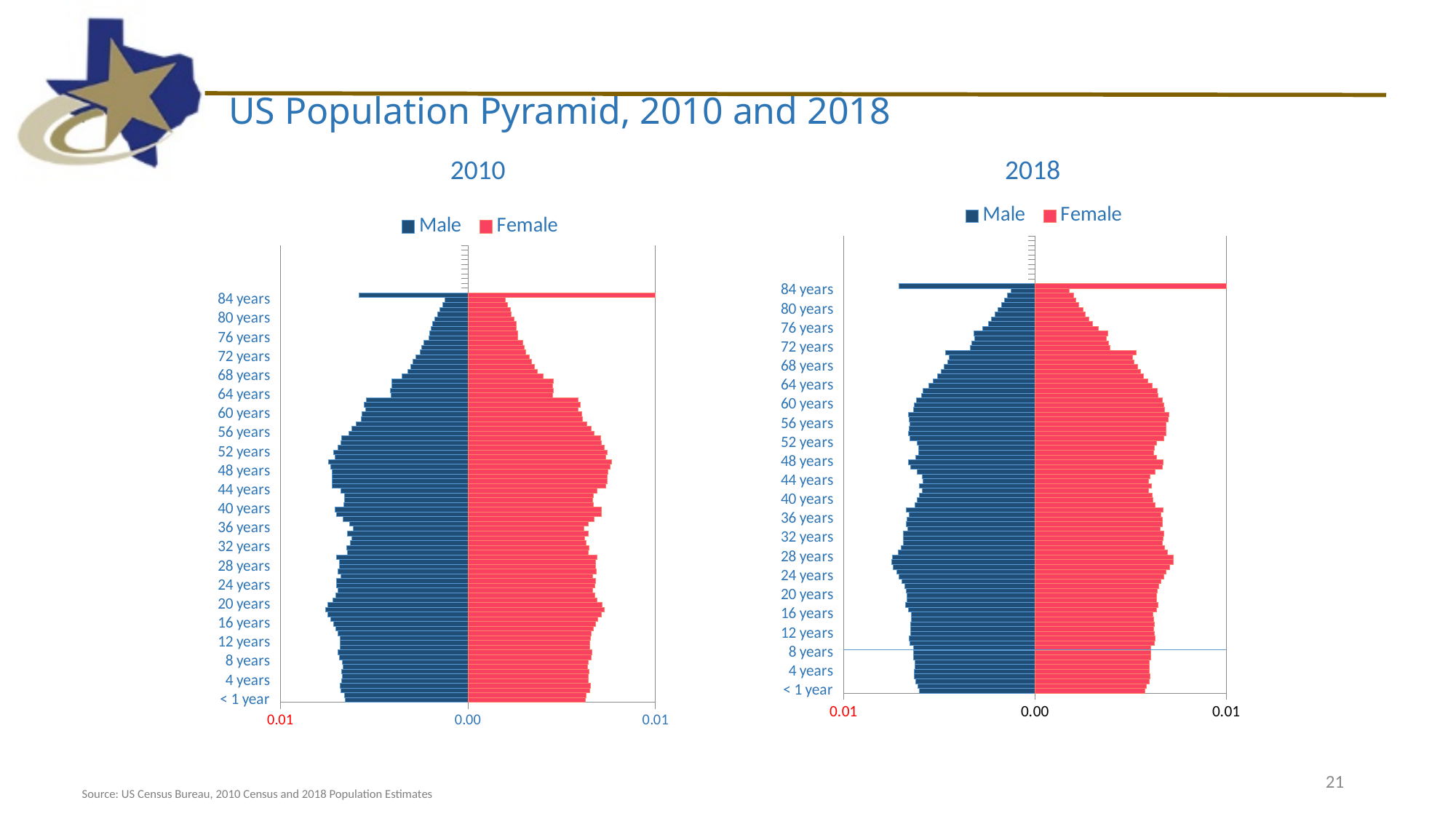
In the 2010 chart, is the Female bar for 48 years longer or shorter than the Female bar for 76 years? longer How many series does the legend of the 2010 chart list? 2 What is the title of the slide's chart pair? US Population Pyramid, 2010 and 2018 In the 2018 chart, which series is shown in red? Female What kind of chart is the 2010 chart? bar chart How many series does the legend of the 2018 chart list? 2 In the 2010 chart, is the Female value for 48 years greater or less than 0.01? less What kind of chart is the 2018 chart? bar chart In the 2018 chart, is the Male value for 28 years greater or less than 0.01? less